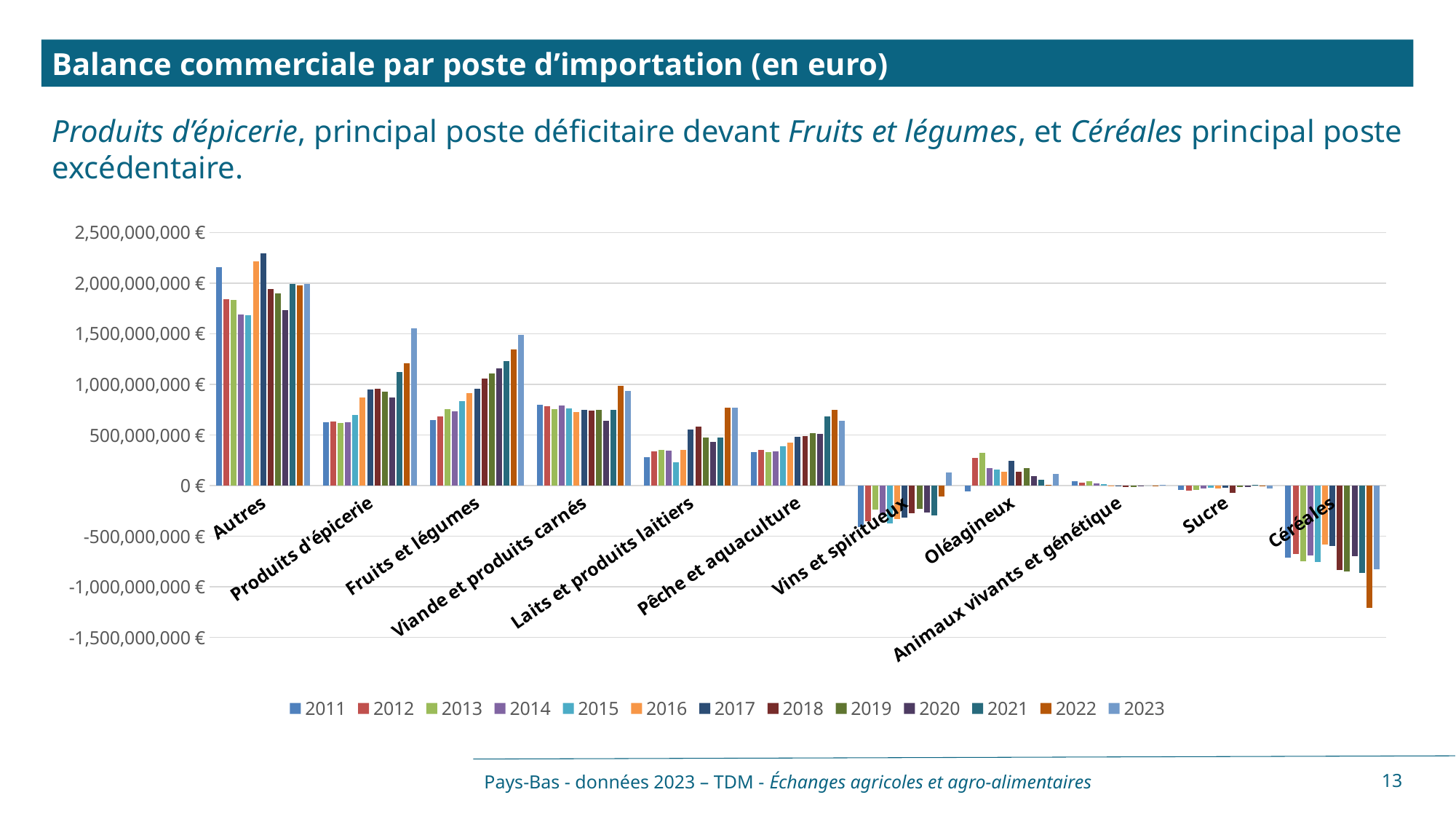
What is the title of the chart on the slide? Balance commerciale par poste d'importation (en euro) How many series (years) does the chart legend list? 13 Do the values for Fruits et légumes generally rise or fall from 2011 to 2023? rise Which category has the lowest (most negative) value in 2022? Céréales Is the value for Céréales in 2022 greater or less than -1,000,000,000 €? less Which is larger in 2023: the value for Autres or the value for Fruits et légumes? Autres Is the value for Vins et spiritueux in 2023 greater or less than 0 €? greater What kind of chart is shown on the slide? Bar chart Is the value for Autres in 2023 greater or less than 1,500,000,000 €? greater How many import categories are shown along the x axis of the chart? 11 Which category has the highest value in 2023? Autres